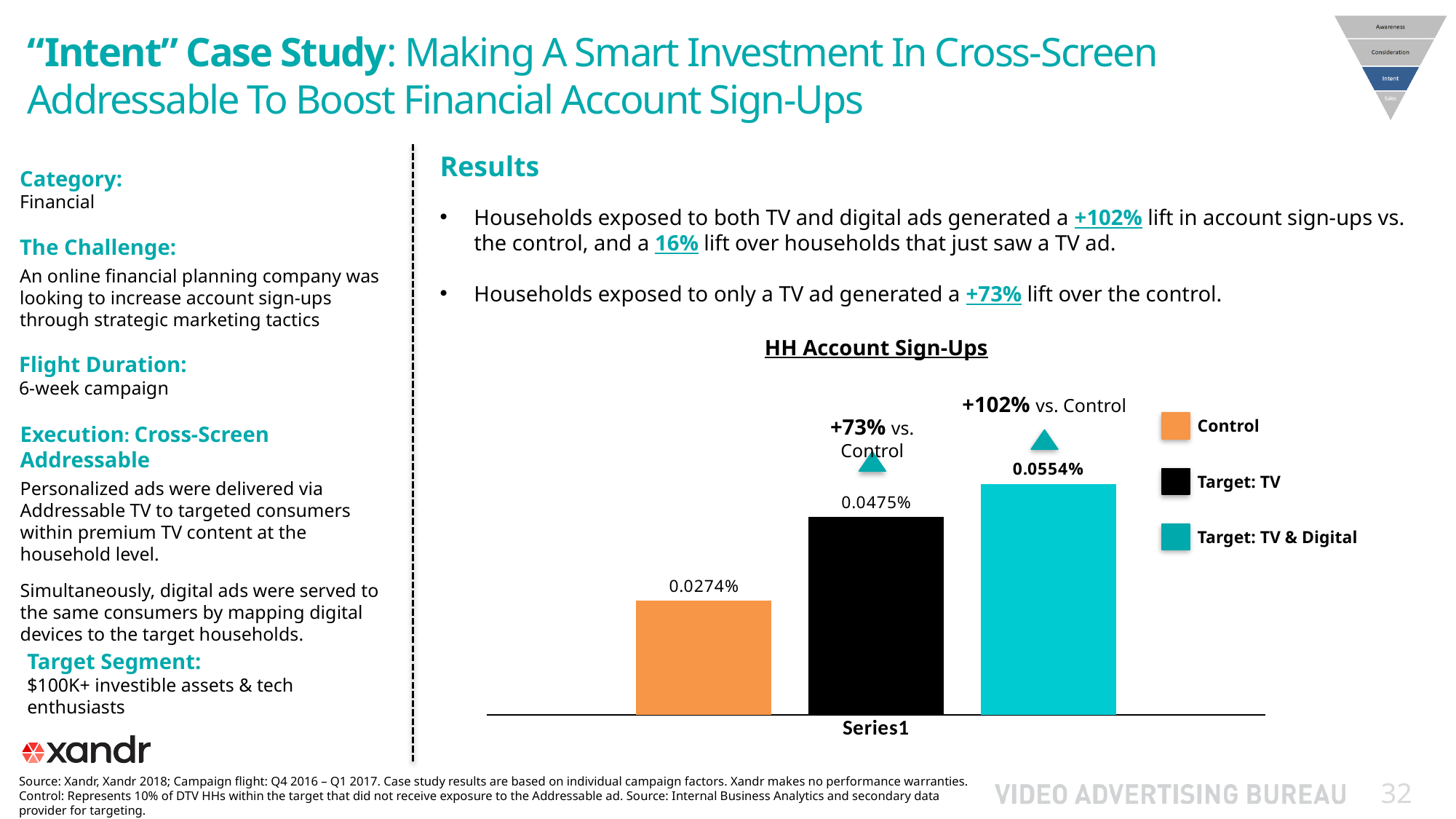
What is the value for Target: TV & Digital in the HH Account Sign-Ups chart? 0.0554% What lift vs. Control is annotated above the Target: TV & Digital bar in the HH Account Sign-Ups chart? +102% Which series has the highest value in the HH Account Sign-Ups chart? Target: TV & Digital What is the difference between the Target: TV value and the Control value in the HH Account Sign-Ups chart? 0.0201% What kind of chart is the HH Account Sign-Ups chart? Bar chart How many series does the legend of the HH Account Sign-Ups chart list? 3 How many bars are plotted in the HH Account Sign-Ups chart? 3 What is the value for Target: TV in the HH Account Sign-Ups chart? 0.0475% What is the value for Control in the HH Account Sign-Ups chart? 0.0274% What is the difference between the Target: TV & Digital value and the Control value in the HH Account Sign-Ups chart? 0.0280% Which is larger in the HH Account Sign-Ups chart, Target: TV or Control? Target: TV Which series has the lowest value in the HH Account Sign-Ups chart? Control